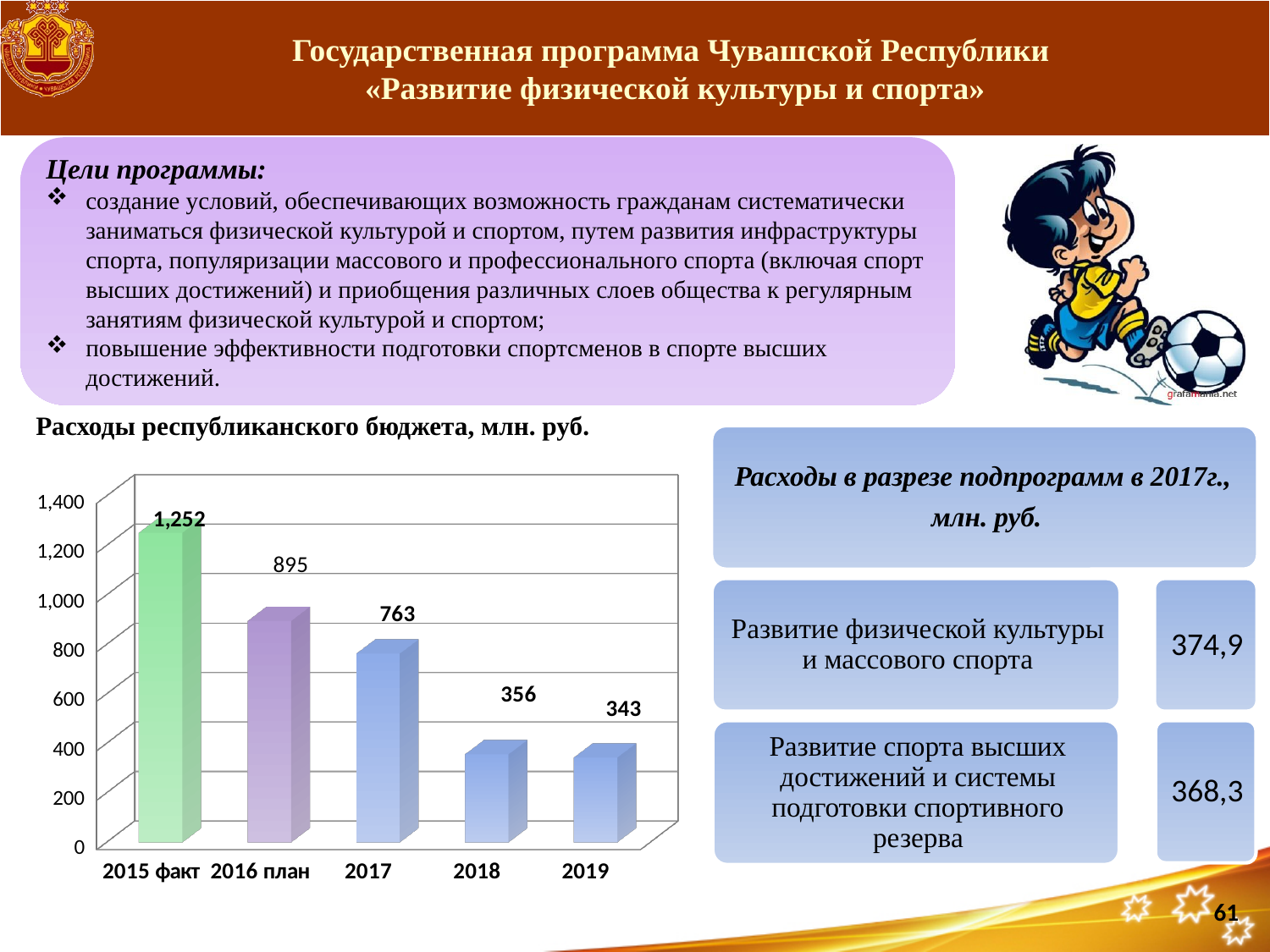
What is the value for 2017 in the chart? 763 What is the difference between the values for 2018 and 2019? 13 Do the values rise or fall from 2015 факт to 2019 along the x axis? fall What is the value for 2019 in the chart? 343 What kind of chart is shown on the slide? bar chart Which is larger, the value for 2017 or the value for 2018? 2017 What is the value for 2016 план in the chart? 895 How many categories are shown on the x axis of the chart? 5 Which category has the lowest value in the chart? 2019 What is the difference between the values for 2016 план and 2017? 132 What is the value for 2015 факт in the chart? 1,252 Which category has the highest value in the chart? 2015 факт